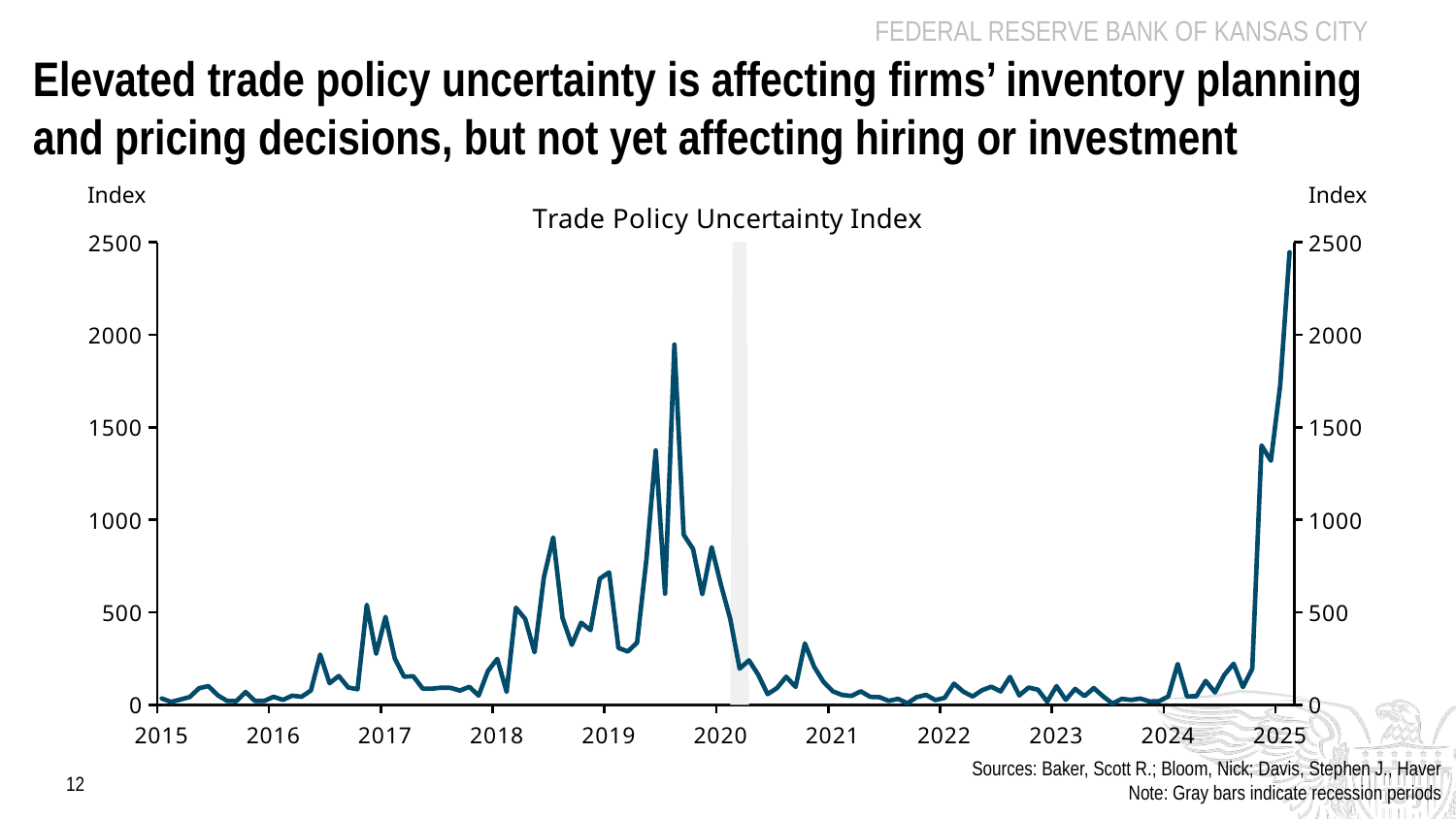
Which is larger, the peak of the index in 2016 or the peak in 2019? 2019 Does the index rise or fall between 2024 and 2025? rise Is the peak value of the index in 2025 greater or less than 2000? greater Is the value of the index during 2022 greater or less than 500? less In which year does the Trade Policy Uncertainty Index reach its highest peak? 2025 Is the peak of the index in 2018 greater or less than 1000? less Which is larger, the peak of the index in 2019 or the peak in 2025? 2025 How many year labels are shown on the horizontal axis? 11 What kind of chart is shown on the slide? line chart What is the title of the chart? Trade Policy Uncertainty Index What is the highest value shown on the vertical axis of the chart? 2500